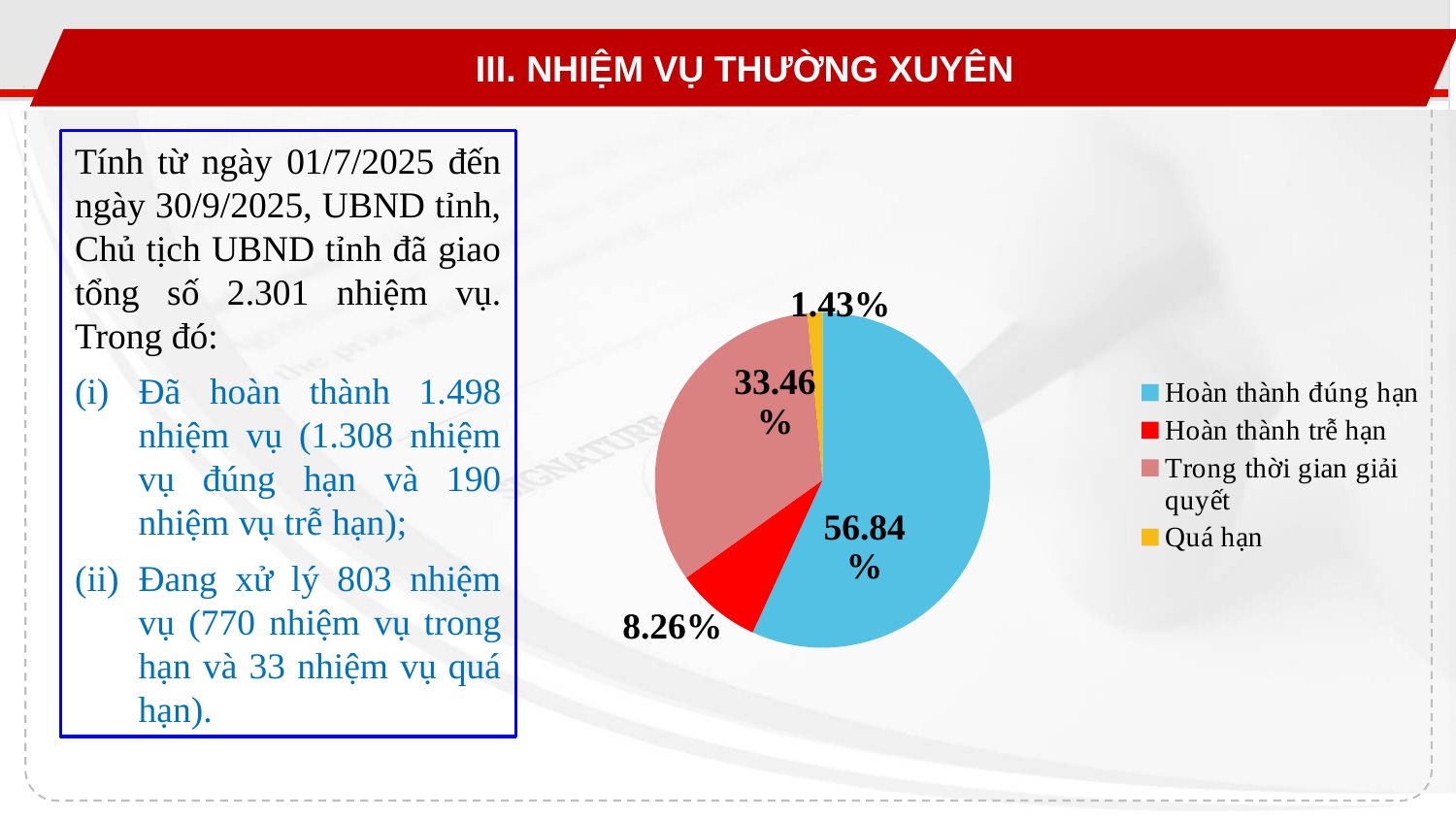
Which is larger in the pie chart: "Hoàn thành trễ hạn" or "Trong thời gian giải quyết"? Trong thời gian giải quyết What percentage does the pie chart show for "Hoàn thành trễ hạn"? 8.26% Which category has the largest slice in the pie chart? Hoàn thành đúng hạn What percentage does the pie chart show for "Quá hạn"? 1.43% What kind of chart is shown on the slide? Pie chart What is the difference in percentage points between "Hoàn thành đúng hạn" and "Trong thời gian giải quyết" in the pie chart? 23.38 What colour is the "Quá hạn" slice in the pie chart? Yellow How many slices does the pie chart have? 4 What percentage does the pie chart show for "Trong thời gian giải quyết"? 33.46% Which category has the smallest slice in the pie chart? Quá hạn What percentage does the pie chart show for "Hoàn thành đúng hạn"? 56.84% How many entries does the legend of the pie chart list? 4